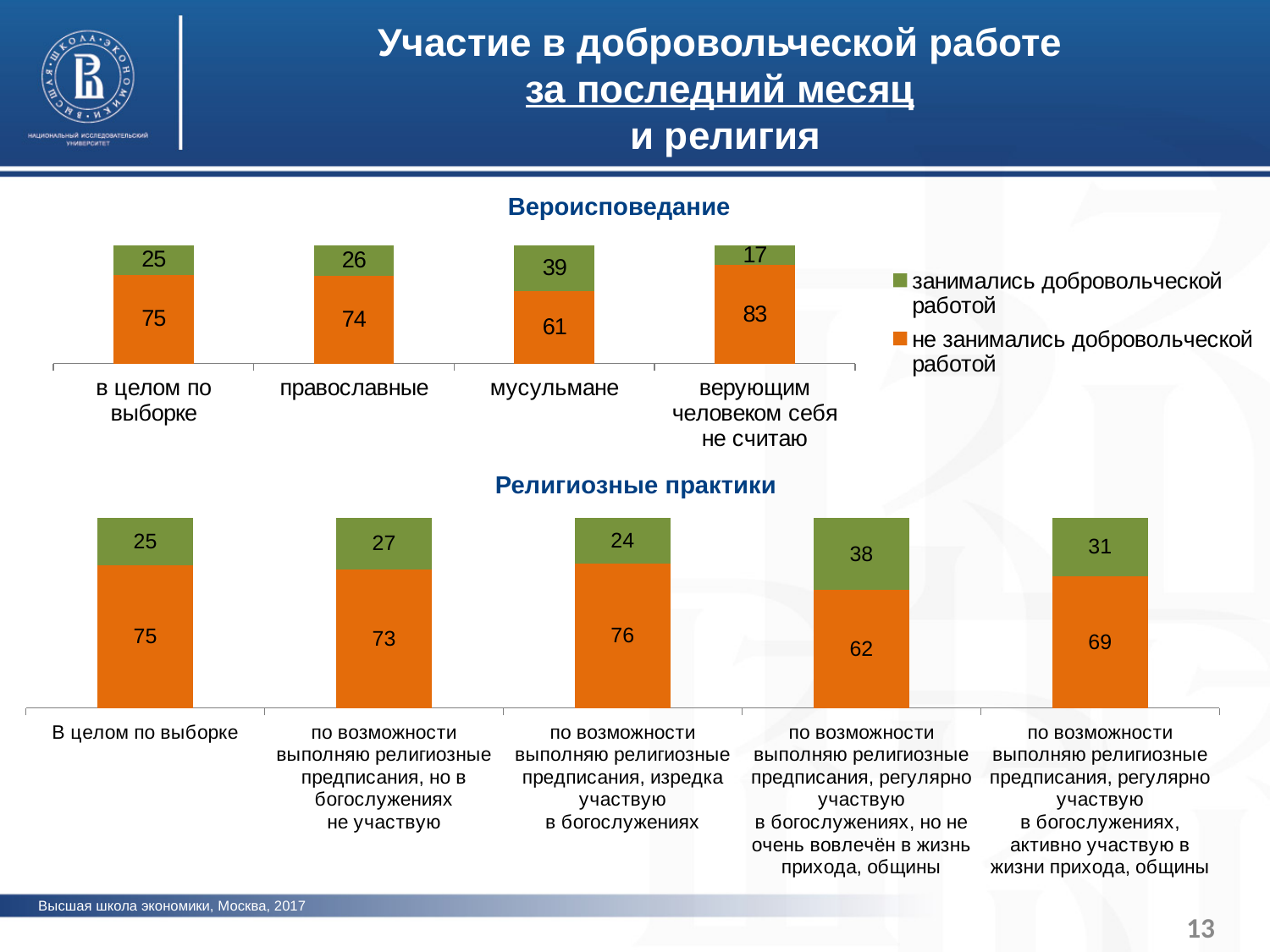
What type of chart is the 'Религиозные практики' chart? stacked bar chart In the 'Вероисповедание' chart, how many categories are shown on the x axis? 4 In the 'Религиозные практики' chart, which category has the highest value for 'не занимались добровольческой работой'? по возможности выполняю религиозные предписания, изредка участвую в богослужениях In the 'Религиозные практики' chart, which is larger: the 'занимались добровольческой работой' value for 'по возможности выполняю религиозные предписания, но в богослужениях не участвую' or for 'по возможности выполняю религиозные предписания, регулярно участвую в богослужениях, активно участвую в жизни прихода, общины'? по возможности выполняю религиозные предписания, регулярно участвую в богослужениях, активно участвую в жизни прихода, общины In the 'Вероисповедание' chart, what is the difference between the 'не занимались добровольческой работой' values for 'верующим человеком себя не считаю' and 'мусульмане'? 22 In the 'Религиозные практики' chart, what is the total of the stacked bar for 'В целом по выборке'? 100 How many series does the legend of the 'Вероисповедание' chart list? 2 In the 'Вероисповедание' chart, what share of 'мусульмане' занимались добровольческой работой? 39 In the 'Вероисповедание' chart, which category has the highest value for 'занимались добровольческой работой'? мусульмане In the 'Вероисповедание' chart, which category has the lowest value for 'занимались добровольческой работой'? верующим человеком себя не считаю In the 'Религиозные практики' chart, what is the value for 'занимались добровольческой работой' for the category 'по возможности выполняю религиозные предписания, регулярно участвую в богослужениях, но не очень вовлечён в жизнь прихода, общины'? 38 In the 'Вероисповедание' chart, what is the value for 'не занимались добровольческой работой' among 'православные'? 74